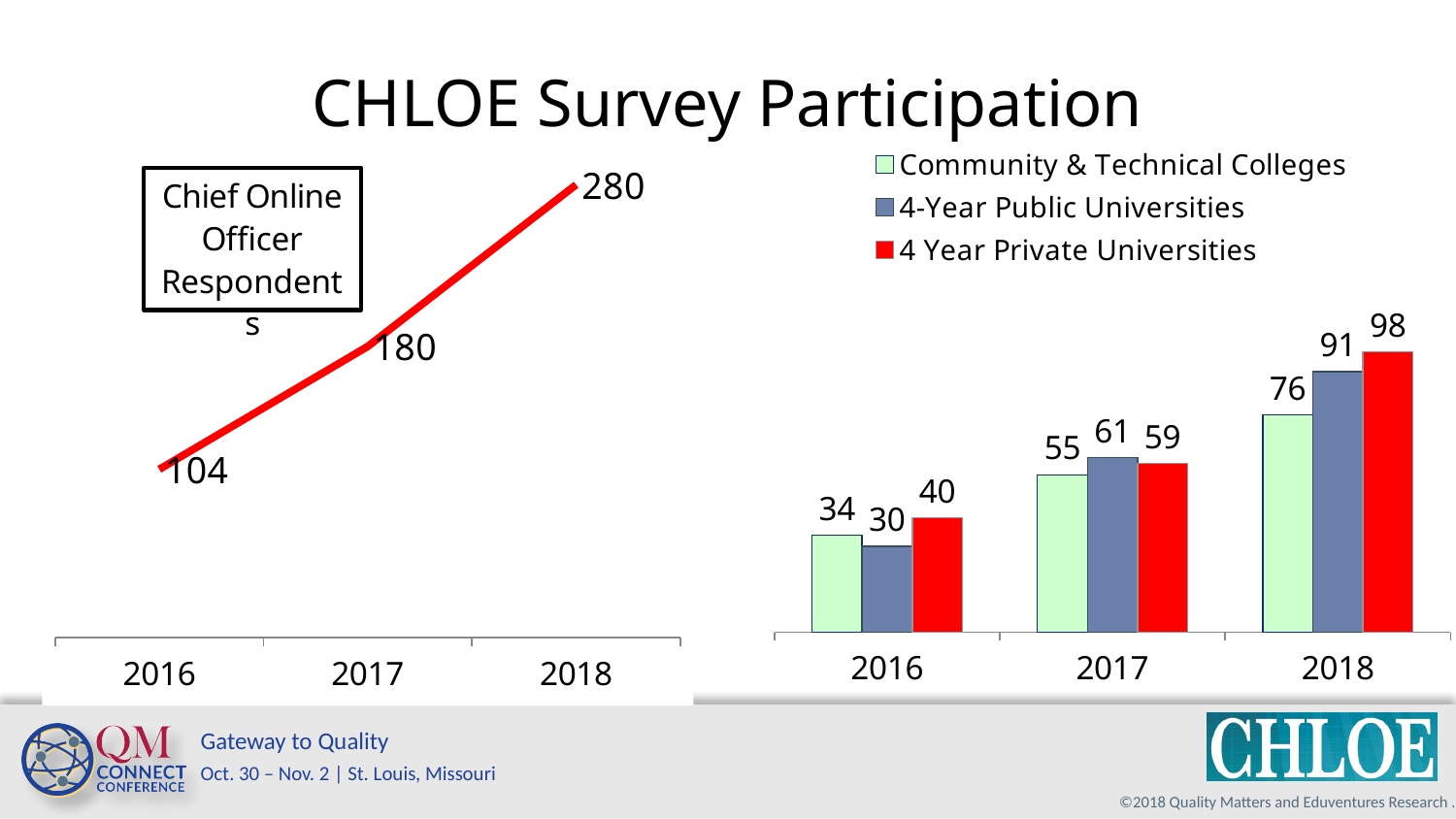
In the line chart on the left, do the values rise or fall from 2016 to 2018? rise In the bar chart on the right, what is the value for 4-Year Public Universities in 2017? 61 In the bar chart on the right, what is the difference between 4 Year Private Universities and Community & Technical Colleges in 2016? 6 In the line chart on the left, by how much did the value increase from 2016 to 2018? 176 In the bar chart on the right, which is larger in 2017: Community & Technical Colleges or 4 Year Private Universities? 4 Year Private Universities What kind of chart is the chart on the left? line chart How many series does the legend of the bar chart on the right list? 3 In the bar chart on the right, what is the value for Community & Technical Colleges in 2018? 76 In the line chart on the left, what is the value for 2018? 280 In the bar chart on the right, which series has the highest value in 2018? 4 Year Private Universities In the bar chart on the right, which series has the lowest value in 2016? 4-Year Public Universities In the line chart on the left, what is the value for 2017? 180